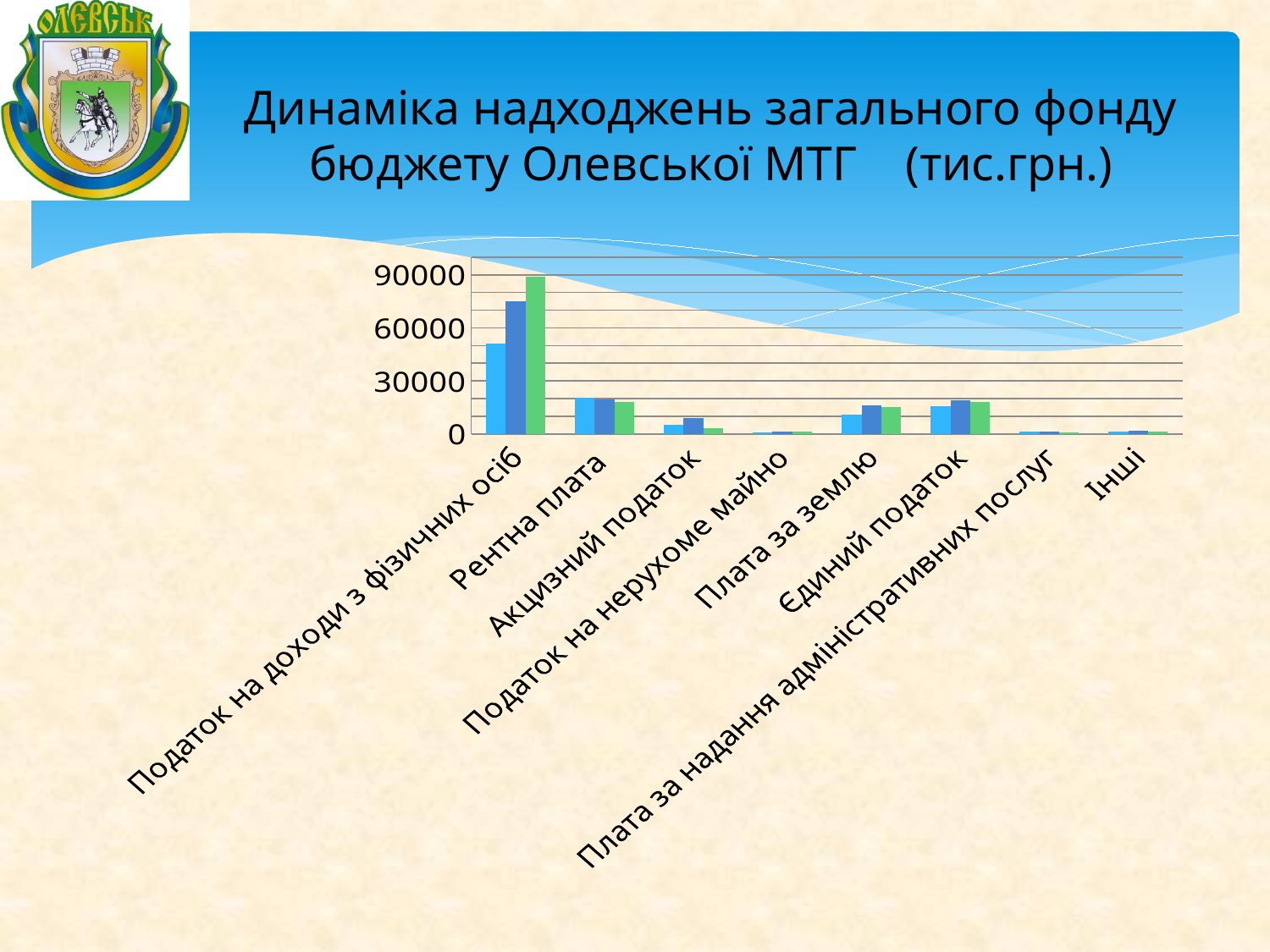
How many categories are shown on the x axis of the chart? 8 Is the value of the leftmost (light blue) bar for Податок на доходи з фізичних осіб greater or less than 60000? less What kind of chart is shown on the slide? bar chart In what units are the values of the chart given, according to the slide title? тис.грн. Are the bars for Рентна плата greater or less than 30000? less Which category has the highest values in the chart? Податок на доходи з фізичних осіб Do the three bars for Податок на доходи з фізичних осіб rise or fall from left to right? rise Which category has larger values, Рентна плата or Акцизний податок? Рентна плата Are the bars for Плата за землю greater or less than 30000? less Which category has larger values, Єдиний податок or Акцизний податок? Єдиний податок How many bars are plotted for each category in the chart? 3